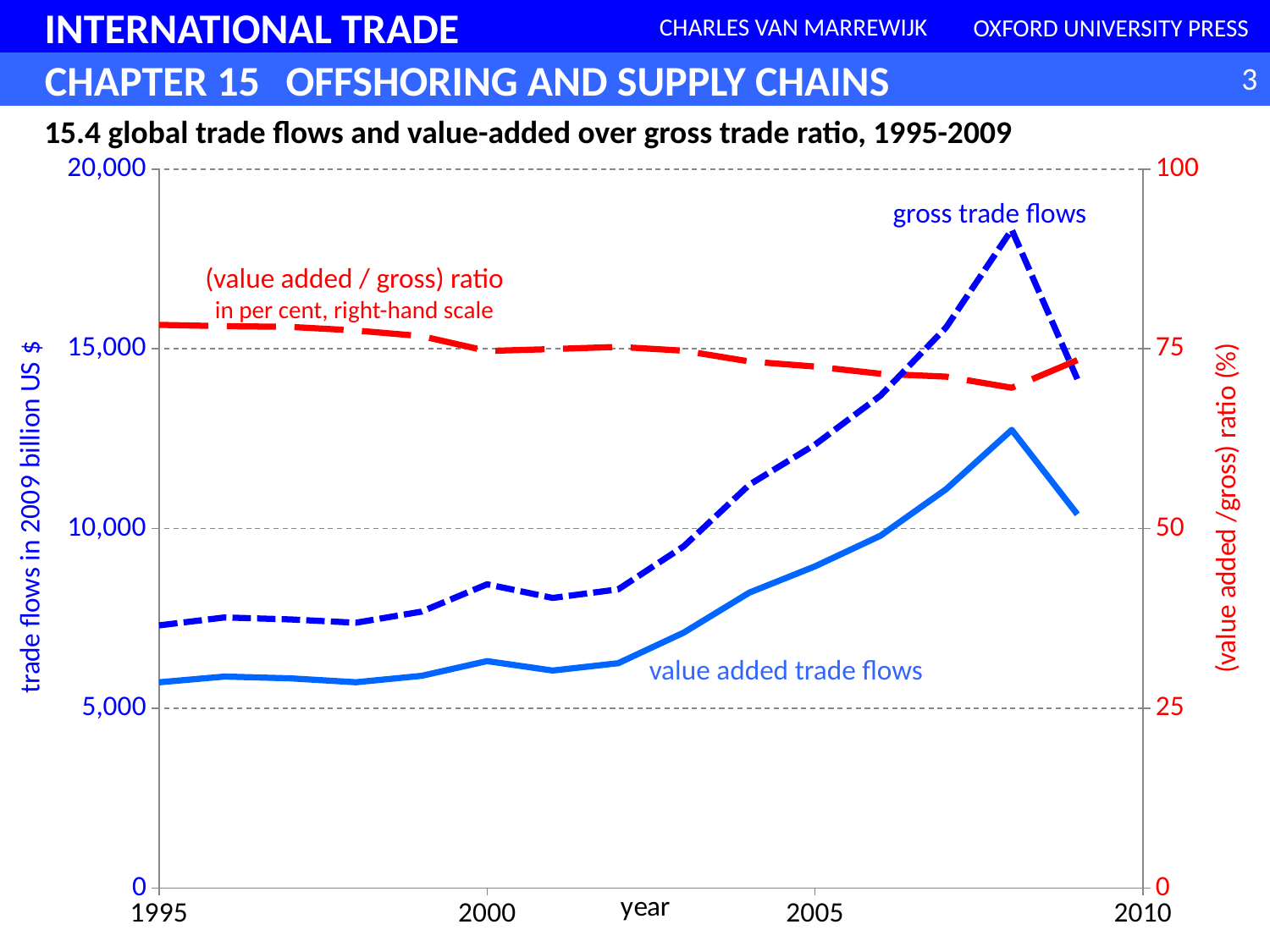
Is the (value added / gross) ratio in 1995 greater or less than 75? greater Is the peak value of gross trade flows greater or less than 15,000? greater Does the (value added / gross) ratio generally rise or fall between 1995 and 2005? fall Is the value for gross trade flows in 1995 greater or less than 10,000? less What is the title of the chart? 15.4 global trade flows and value-added over gross trade ratio, 1995-2009 What kind of chart is shown on the slide? line chart How many data series are plotted on the chart? 3 Do value added trade flows generally rise or fall between 2000 and 2005? rise What is the label of the left-hand vertical axis? trade flows in 2009 billion US $ In 2005, which is larger: gross trade flows or value added trade flows? gross trade flows